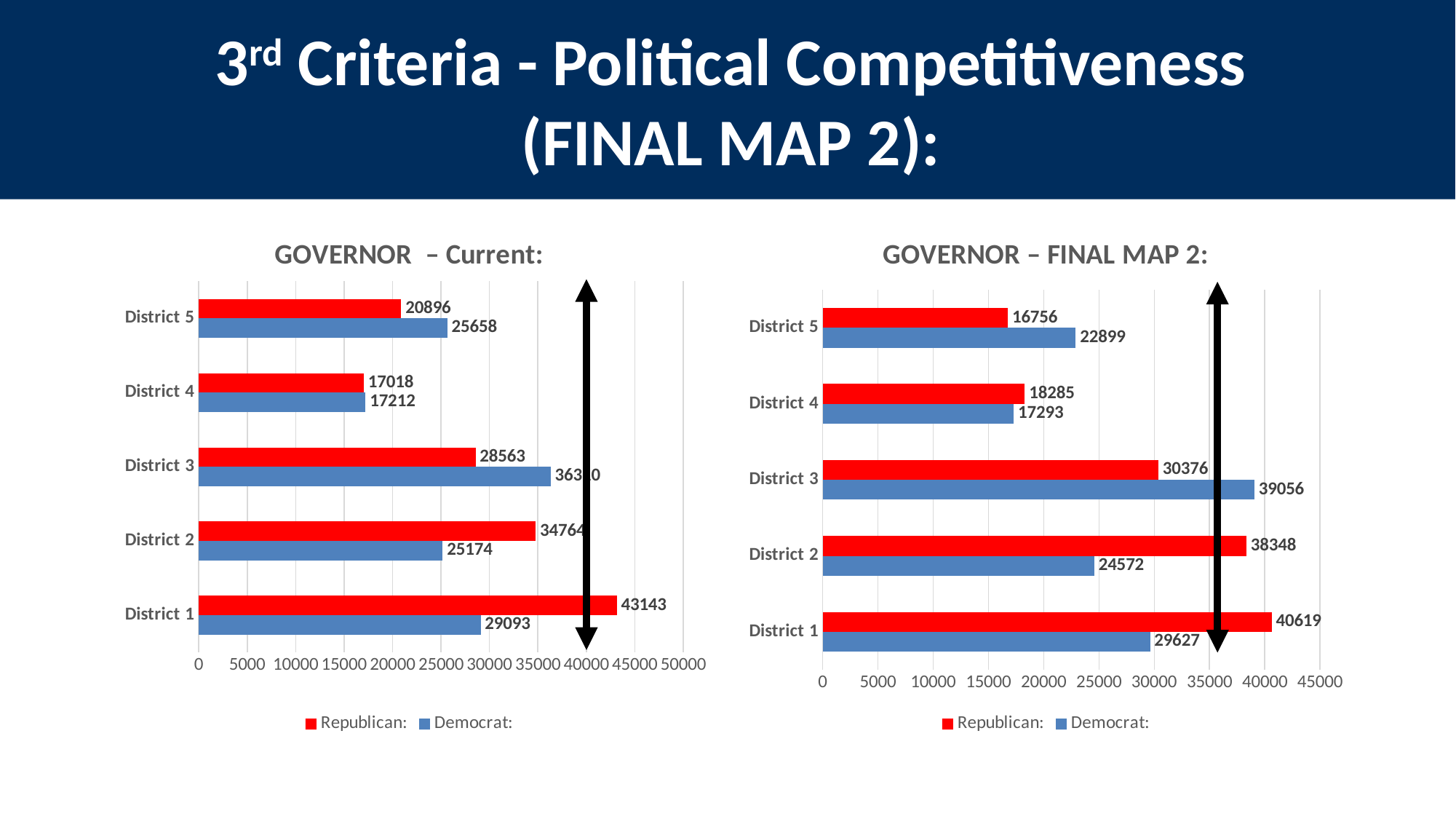
In the GOVERNOR – Current chart, is the Democrat value for District 3 greater or less than 35000? greater In the GOVERNOR – FINAL MAP 2 chart, what is the Democrat value for District 3? 39056 In the GOVERNOR – FINAL MAP 2 chart, what is the difference between the Republican and Democrat values for District 1? 10992 What kind of chart is the GOVERNOR – Current chart? Bar chart In the GOVERNOR – Current chart, what is the Republican value for District 1? 43143 In the GOVERNOR – Current chart, what is the difference between the Republican and Democrat values for District 2? 9590 How many districts are shown in the GOVERNOR – FINAL MAP 2 chart? 5 In the GOVERNOR – FINAL MAP 2 chart, which is larger for District 4, the Republican value or the Democrat value? Republican How many series does the legend of the GOVERNOR – Current chart list? 2 In the GOVERNOR – FINAL MAP 2 chart, which district has the lowest Democrat value? District 4 In the GOVERNOR – FINAL MAP 2 chart, what is the Republican value for District 5? 16756 In the GOVERNOR – Current chart, which district has the highest Republican value? District 1